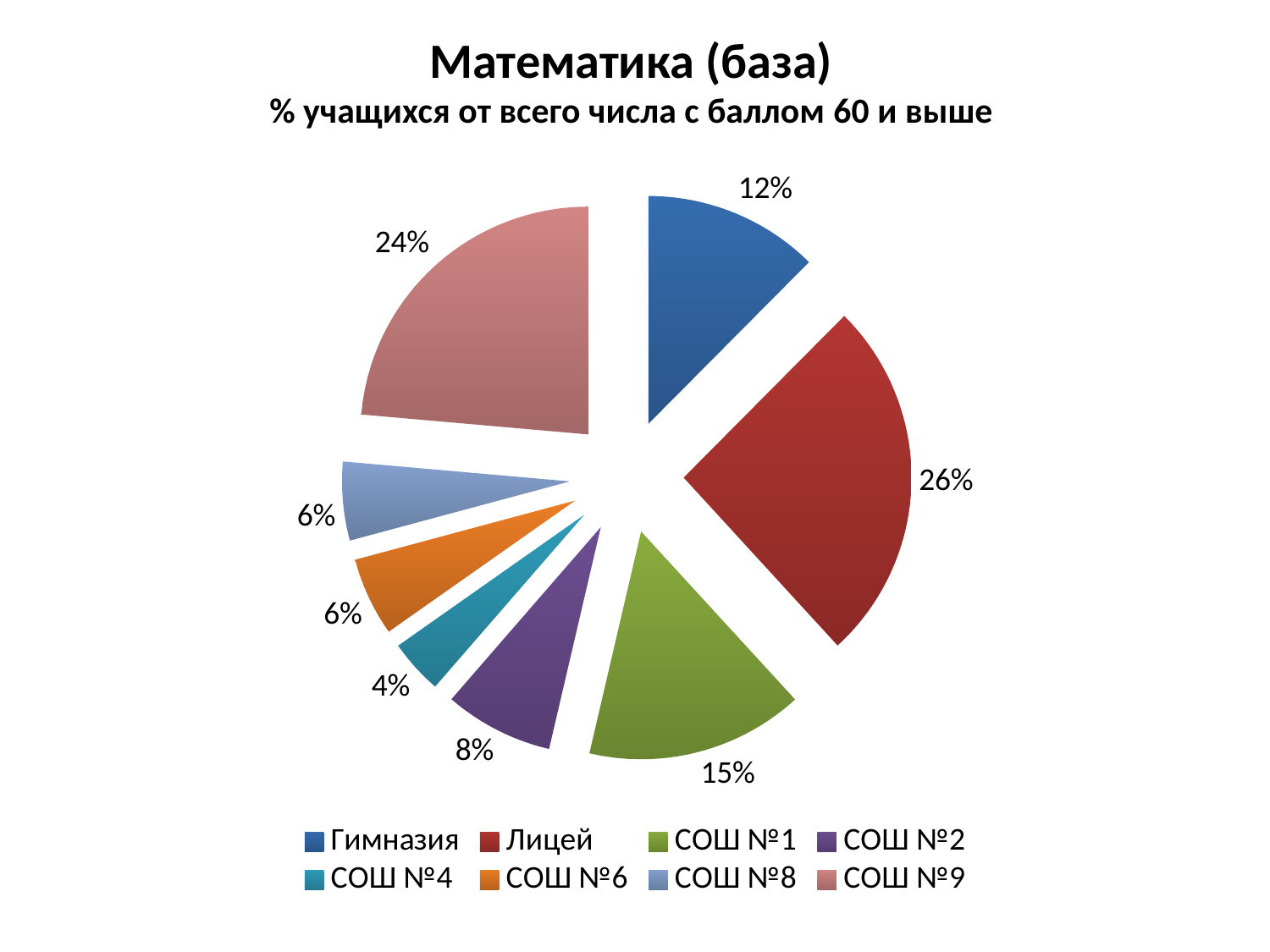
What is the difference between the values for Лицей and СОШ №9? 2% Which school has the smallest slice of the pie? СОШ №4 What is the value shown for СОШ №9? 24% What is the title of the chart? Математика (база) What is the value shown for Гимназия? 12% What type of chart is shown on the slide? pie chart What is the value shown for СОШ №1? 15% What share of the pie does Лицей have? 26% What colour is the slice for СОШ №6? orange Which school has the largest slice of the pie? Лицей Which is larger, the value for СОШ №1 or the value for СОШ №2? СОШ №1 How many categories does the legend list? 8